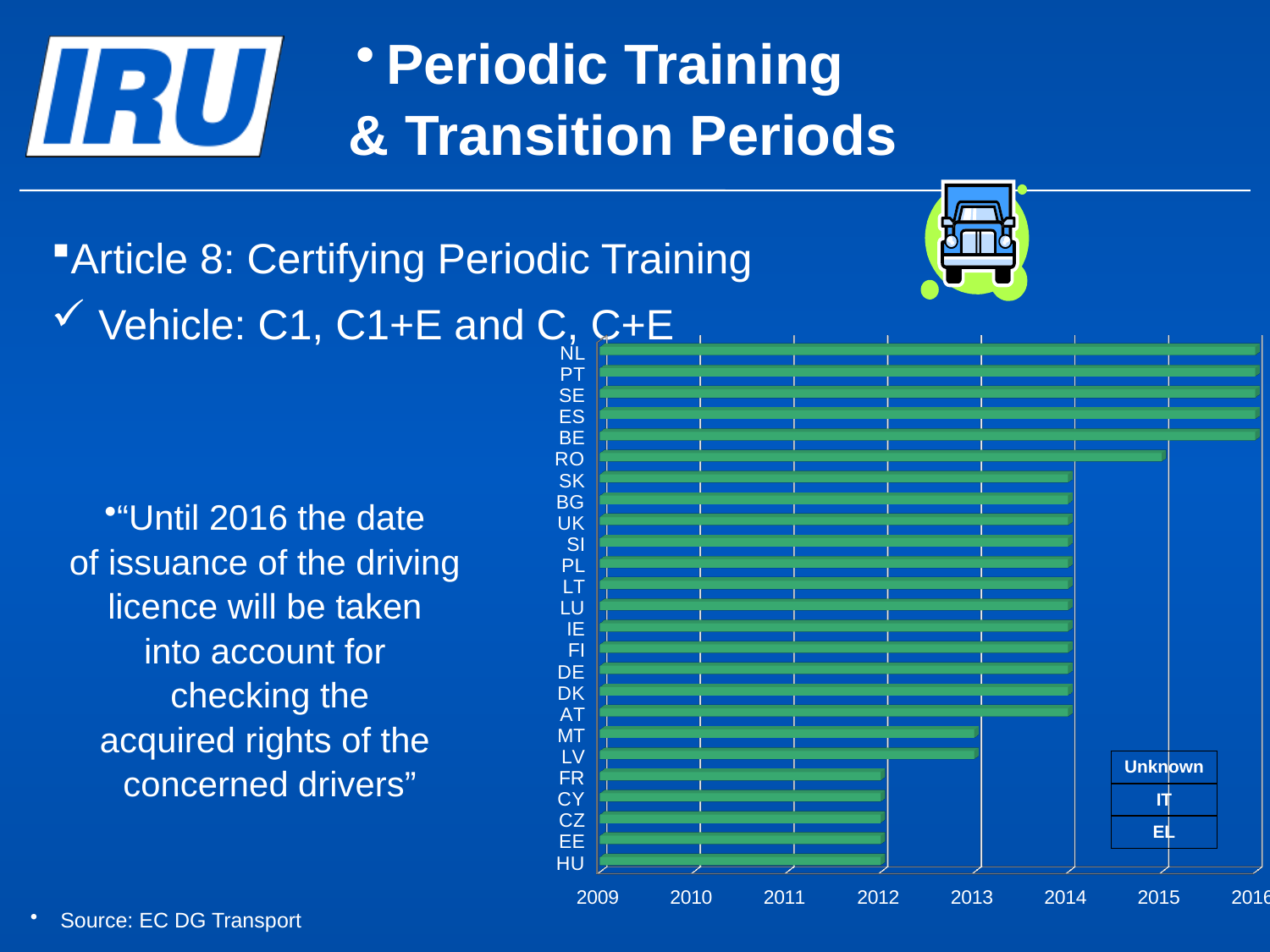
What kind of chart is shown on the slide? bar chart Is the bar for SK longer or shorter than the bar for FR? longer Does the bar for DE extend beyond 2013? yes Which year does the bar for HU end at? 2012 How many countries are listed on the vertical axis of the chart? 25 Does the bar for CZ extend beyond 2013? no Which year does the bar for RO end at? 2015 Which year does the bar for NL end at? 2016 Which countries are listed in the 'Unknown' box on the chart? IT and EL What is the first year shown on the horizontal axis of the chart? 2009 Which year does the bar for MT end at? 2013 Is the bar for LV longer or shorter than the bar for BE? shorter